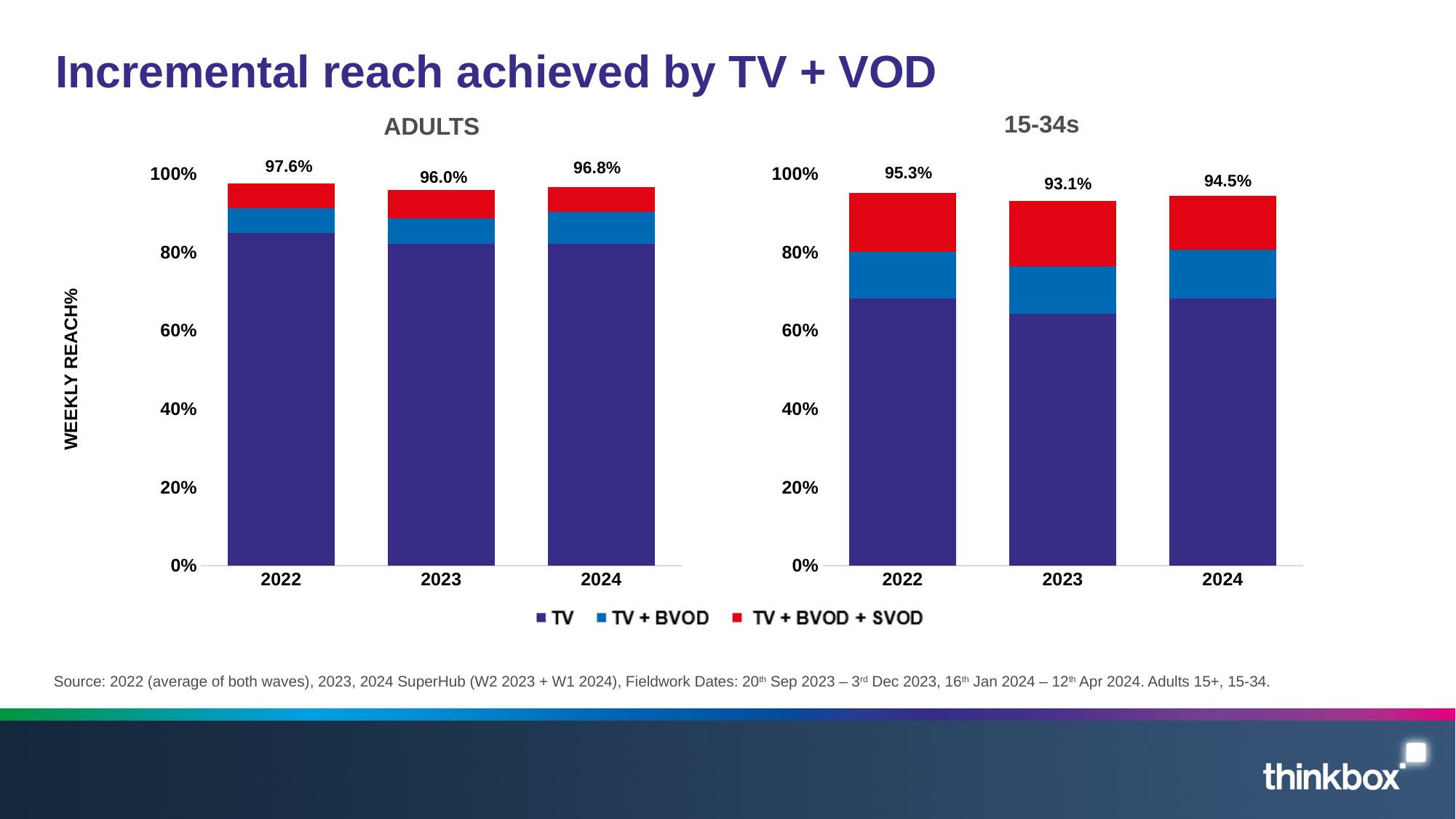
In the ADULTS chart, is the TV-only value for 2022 greater or less than 80%? greater In the ADULTS chart, which year has the highest total weekly reach? 2022 In the 15-34s chart, what is the total weekly reach shown for 2024? 94.5% Which is larger: the 2024 total reach in the ADULTS chart or the 2024 total reach in the 15-34s chart? ADULTS (96.8%) In the ADULTS chart, what is the total weekly reach shown for 2022? 97.6% In the 15-34s chart, which year has the lowest total weekly reach? 2023 What kind of chart is the ADULTS chart? Stacked bar chart How many series does the legend list? 3 In the 15-34s chart, what is the total weekly reach shown for 2023? 93.1% In the 15-34s chart, is the TV-only value for 2022 greater or less than 80%? less In the 15-34s chart, what is the difference between the total reach in 2022 and in 2023? 2.2 percentage points In the ADULTS chart, what is the difference between the total reach in 2022 and in 2023? 1.6 percentage points